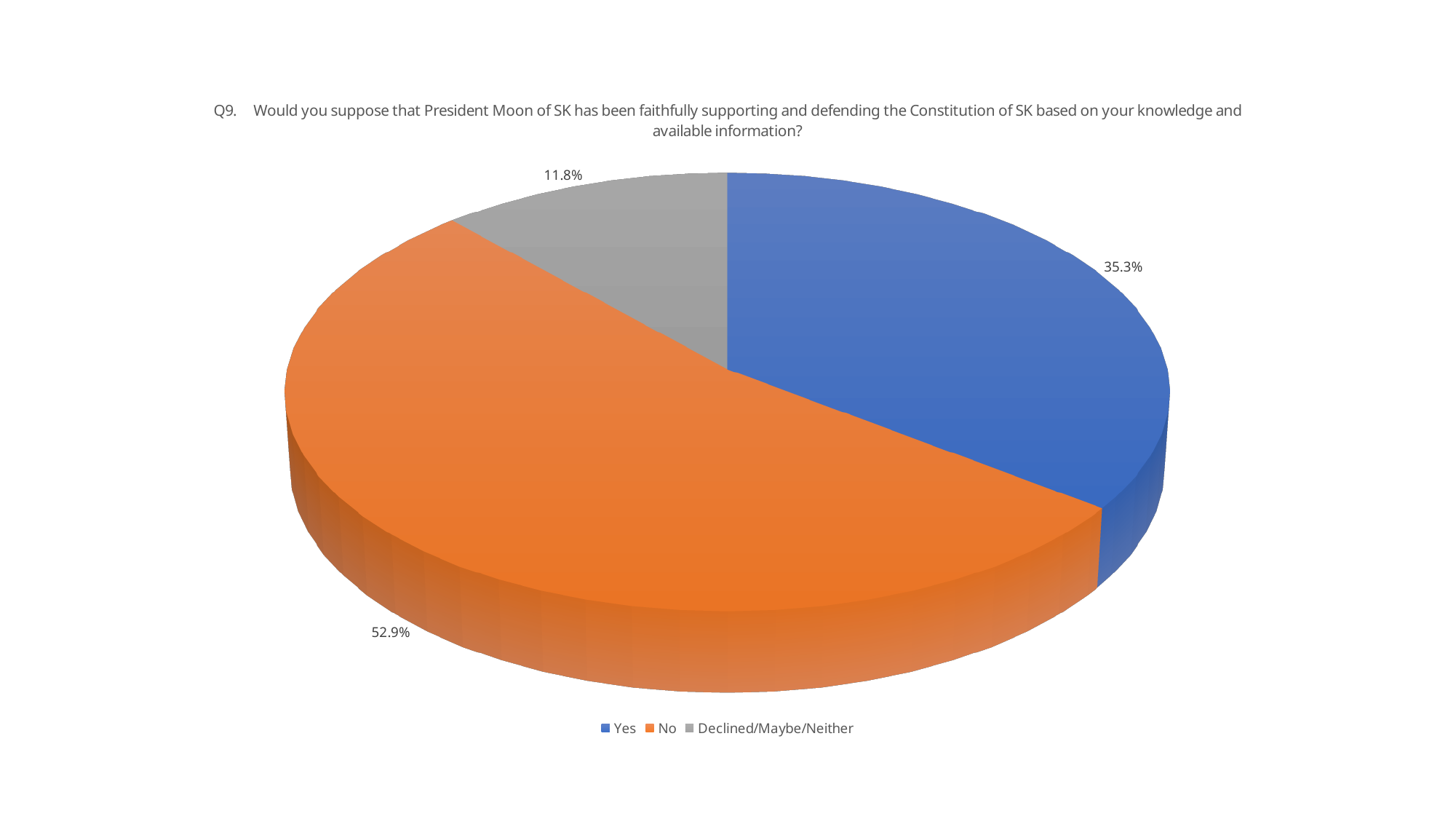
What is the difference in percentage points between the "Yes" share and the "Declined/Maybe/Neither" share? 23.5 What kind of chart is shown on the slide? pie chart Which response has the largest share of the pie? No What percentage of respondents answered "Declined/Maybe/Neither"? 11.8% What percentage of respondents answered "No"? 52.9% What colour is the slice for "No"? orange Which is larger, the share for "Yes" or the share for "No"? No How many slices does the pie chart have? 3 Which response has the smallest share of the pie? Declined/Maybe/Neither How many entries does the legend list? 3 What percentage of respondents answered "Yes"? 35.3% What is the difference in percentage points between the "No" share and the "Yes" share? 17.6